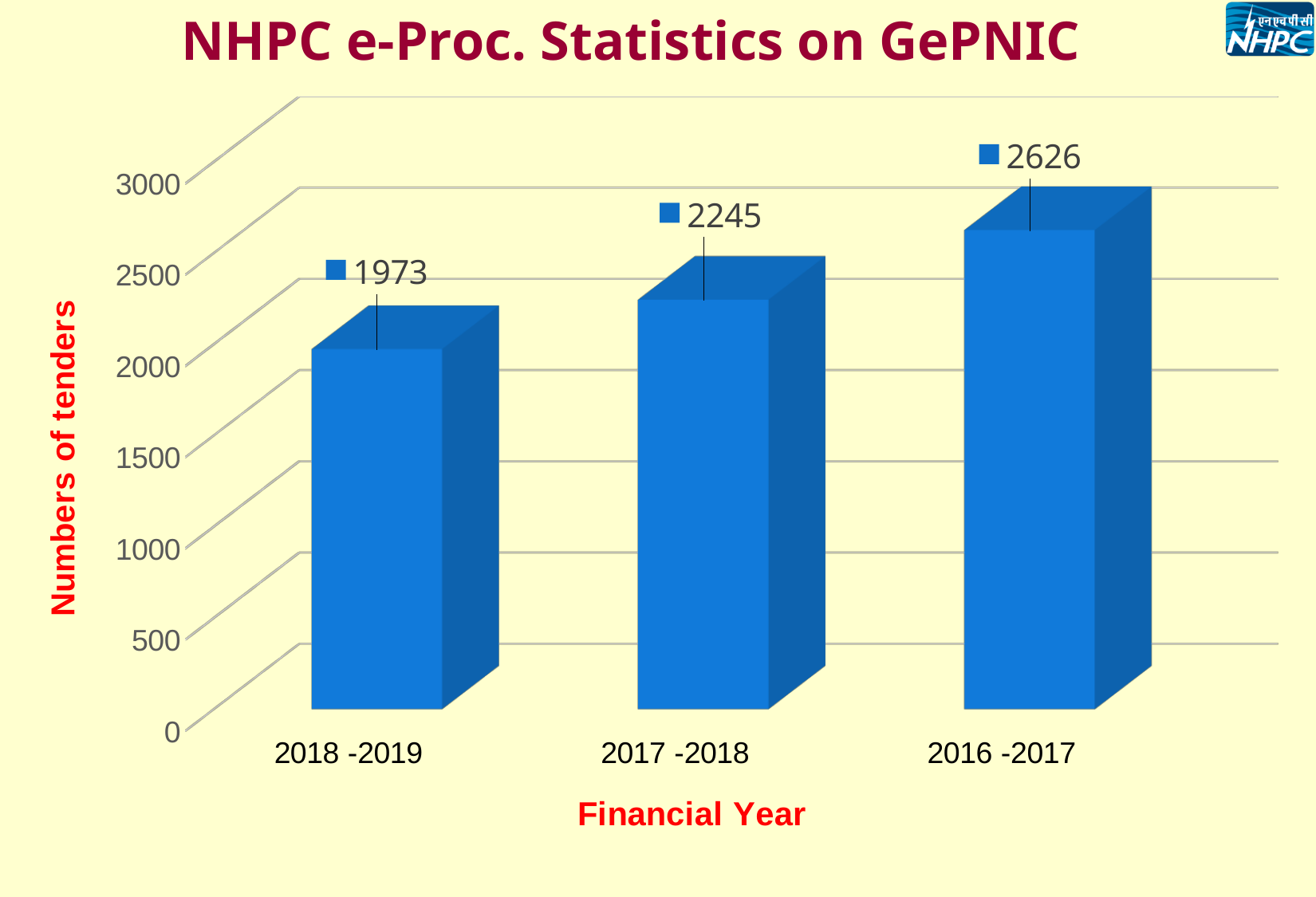
What is the difference in number of tenders between 2016 -2017 and 2018 -2019? 653 What kind of chart is shown on the slide? bar chart Which financial year has the lowest number of tenders? 2018 -2019 Which has more tenders, 2017 -2018 or 2016 -2017? 2016 -2017 How many financial years are shown on the chart? 3 Which financial year has the highest number of tenders? 2016 -2017 Is the value for 2018 -2019 greater or less than 2000? less What is the number of tenders for 2018 -2019? 1973 What is the number of tenders for 2016 -2017? 2626 What is the label of the vertical axis? Numbers of tenders What is the difference in number of tenders between 2017 -2018 and 2018 -2019? 272 What is the number of tenders for 2017 -2018? 2245